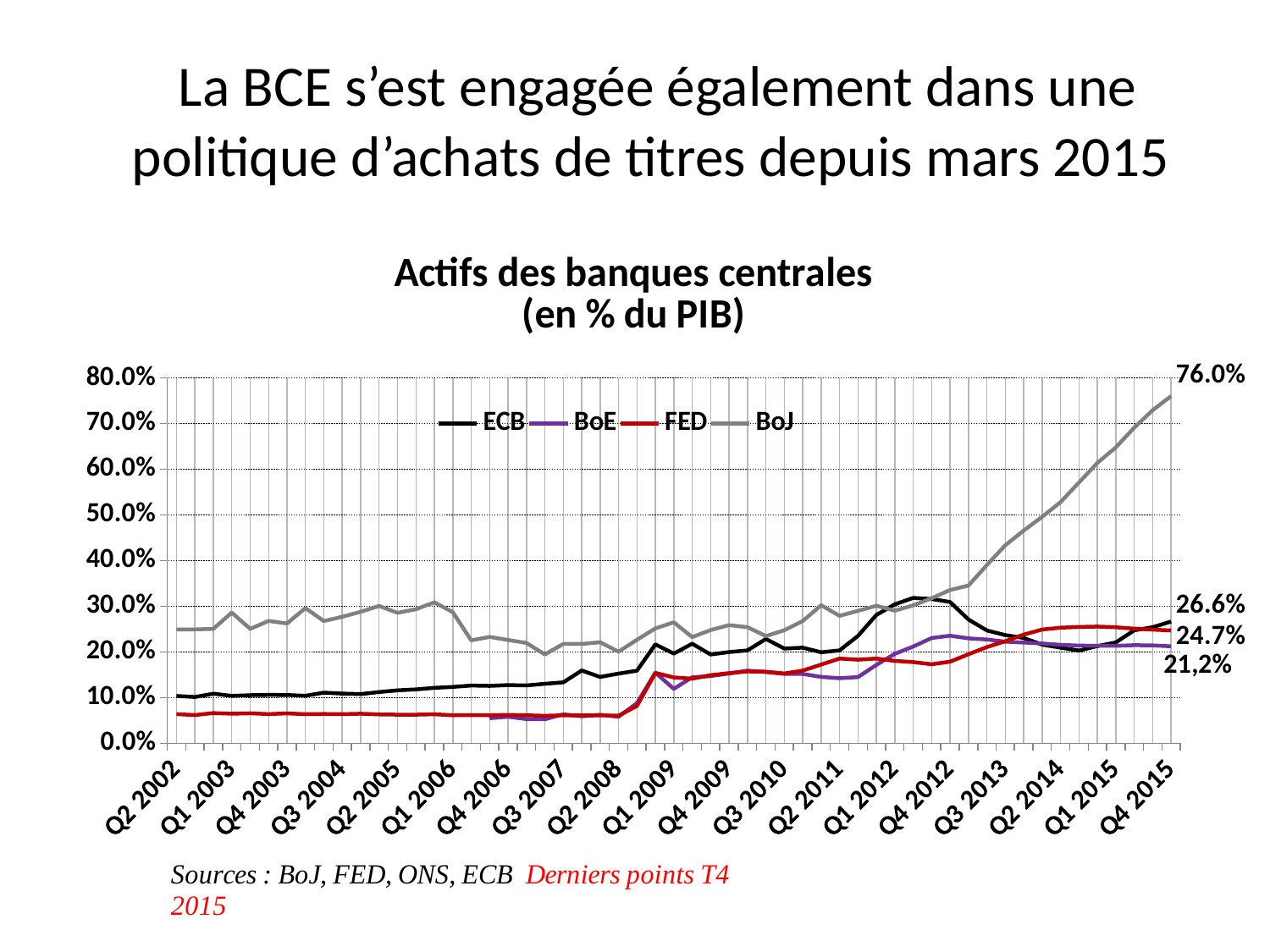
What is the value for BoE at Q4 2015? 21,2% What is the title of the chart? Actifs des banques centrales (en % du PIB) What is the value for BoJ at Q4 2015? 76.0% How many series does the legend list? 4 What type of chart is shown on the slide? Line chart Which series has the highest value at Q4 2015? BoJ What is the value for FED at Q4 2015? 24.7% What is the value for ECB at Q4 2015? 26.6% What is the difference between the BoJ and ECB values at Q4 2015? 49.4 percentage points Is the value for BoJ at Q2 2002 greater or less than 20%? greater Which series has the lowest value at Q4 2015? BoE Does the BoJ series rise or fall between Q3 2013 and Q4 2015? Rise